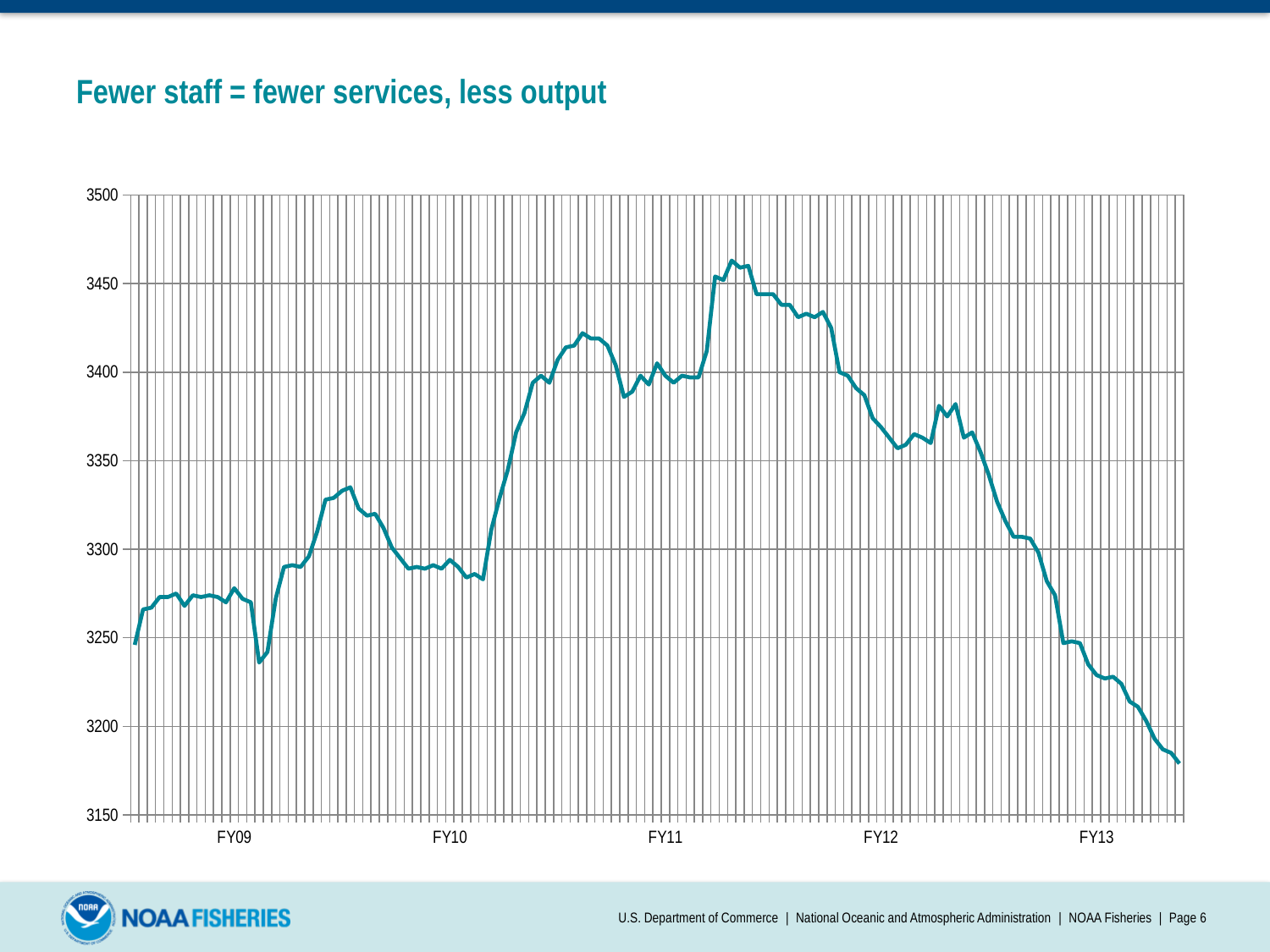
What is the highest value shown on the y axis? 3500 Is the final value at the right end of the line greater or less than 3200? less How many lines are plotted on the chart? 1 Is the value at the FY12 label greater or less than 3400? less What is the title of the slide containing the chart? Fewer staff = fewer services, less output What kind of chart is shown on the slide? line chart Does the line rise or fall between the FY12 and FY13 labels? fall Is the value at the FY09 label greater or less than 3250? greater Between which two fiscal year labels does the line reach its highest point? between FY11 and FY12 Does the line rise or fall overall between the FY09 and FY11 labels? rise How many fiscal year labels are shown on the x axis? 5